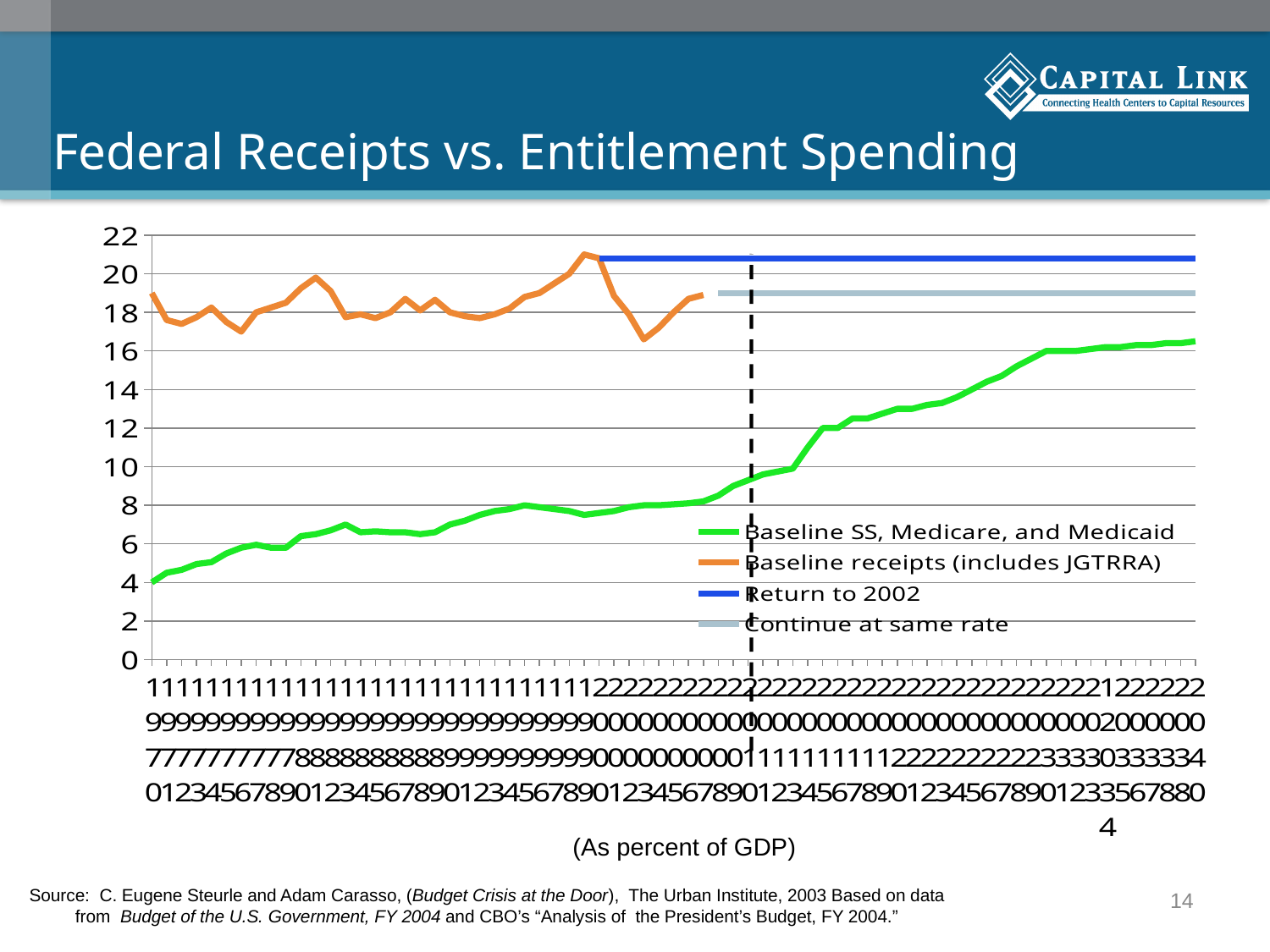
How many series does the legend list? 4 Is the value of the Baseline SS, Medicare, and Medicaid line at the left end of the chart greater or less than 6? less What kind of chart is shown on the slide? Line chart Is the Continue at same rate line greater or less than 20? less Is the value of the Baseline SS, Medicare, and Medicaid line at the right end of the chart greater or less than 14? greater Which series has the lowest values at the left end of the chart? Baseline SS, Medicare, and Medicaid Which legend entry is drawn in green? Baseline SS, Medicare, and Medicaid What is the title of the chart? Federal Receipts vs. Entitlement Spending Does the Baseline SS, Medicare, and Medicaid line rise or fall from left to right? Rise Which line is higher on the chart, Return to 2002 or Continue at same rate? Return to 2002